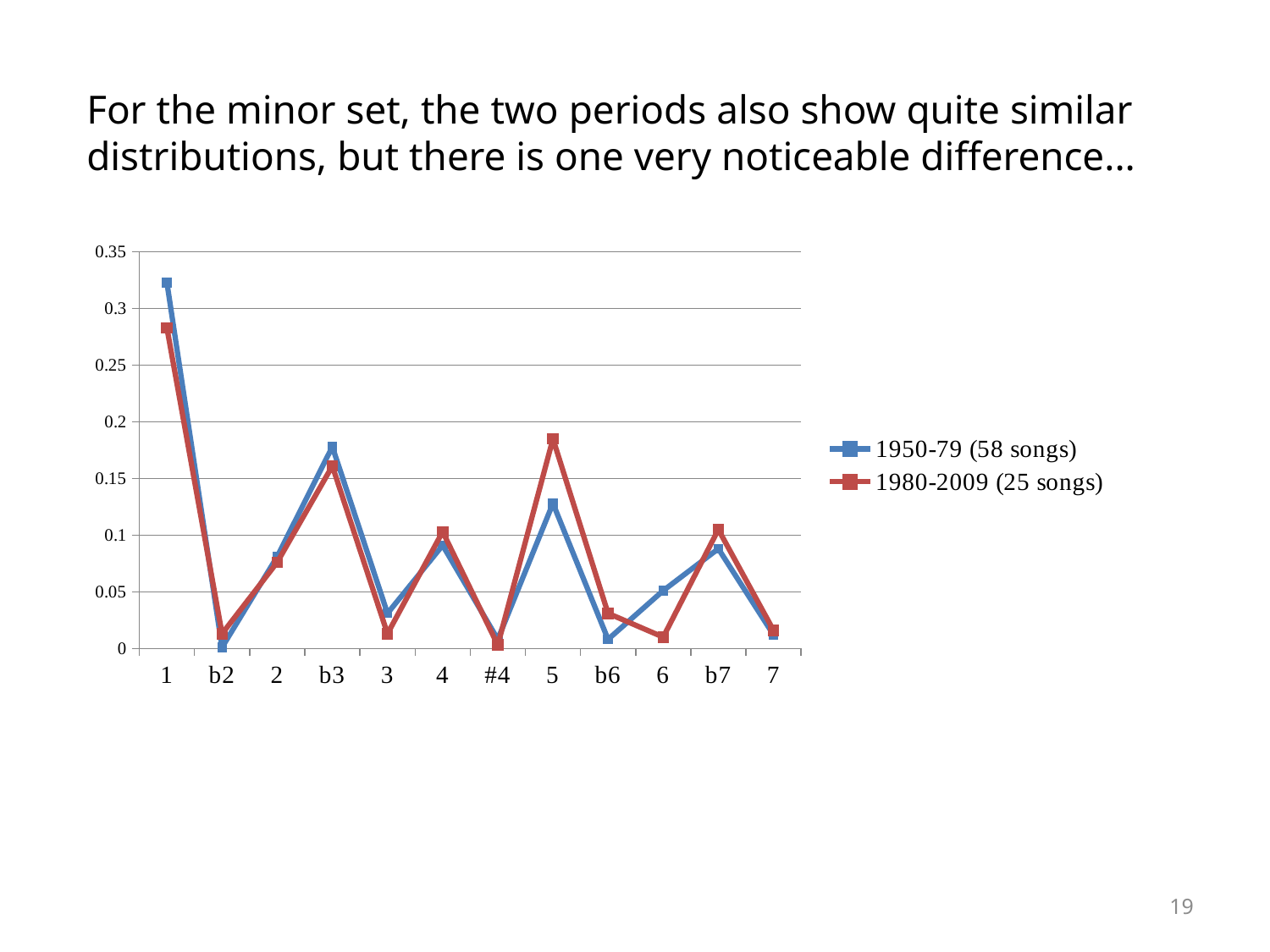
At category 6, which series has the larger value, 1950-79 (58 songs) or 1980-2009 (25 songs)? 1950-79 (58 songs) How many categories are shown on the x axis? 12 At category 1, which series has the larger value, 1950-79 (58 songs) or 1980-2009 (25 songs)? 1950-79 (58 songs) Is the value for category 1 in the 1950-79 (58 songs) series greater or less than 0.3? greater How many series does the legend list? 2 Which colour is used for the 1980-2009 (25 songs) series? Red What kind of chart is shown on the slide? Line chart Is the value for category 5 in the 1980-2009 (25 songs) series greater or less than 0.15? greater Is the value for category 5 in the 1950-79 (58 songs) series greater or less than 0.15? less Which category has the highest value for the 1980-2009 (25 songs) series? 1 At category 5, which series has the larger value, 1950-79 (58 songs) or 1980-2009 (25 songs)? 1980-2009 (25 songs) Which category has the highest value for the 1950-79 (58 songs) series? 1